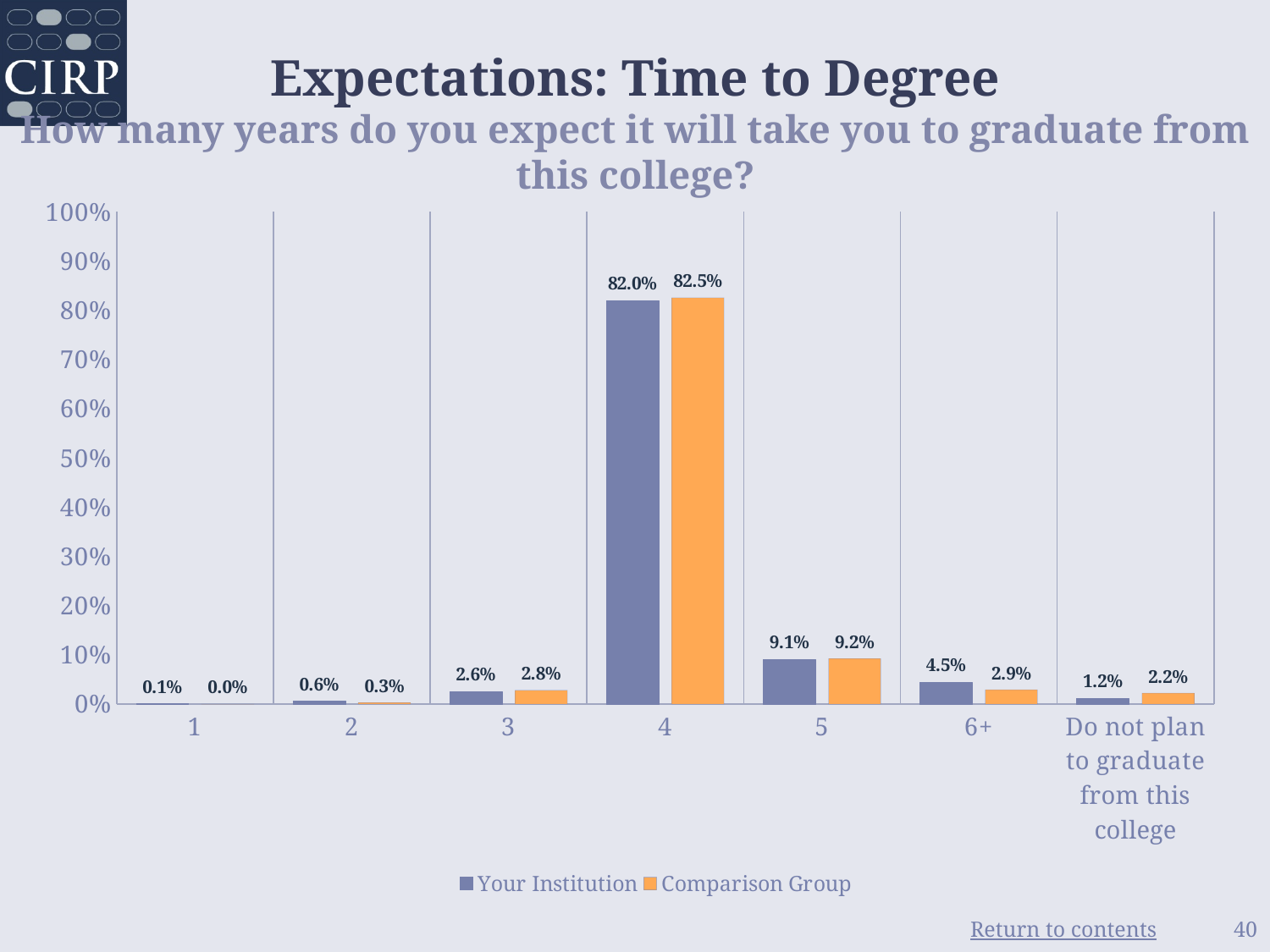
Which category has the highest value for Comparison Group? 4 For the category 6+, which series has the larger value, Your Institution or Comparison Group? Your Institution What is the value for Your Institution for the category 4? 82.0% How many categories are shown on the x axis? 7 What is the difference between the Comparison Group and Your Institution values for the category 4? 0.5% Which category has the lowest value for Your Institution? 1 What kind of chart is shown on the slide? Bar chart What is the difference between Your Institution and Comparison Group for the category 6+? 1.6% What is the value for Your Institution for 'Do not plan to graduate from this college'? 1.2% How many series does the legend list? 2 Is the value for Your Institution for the category 4 greater or less than 80%? greater What is the value for Comparison Group for the category 6+? 2.9%